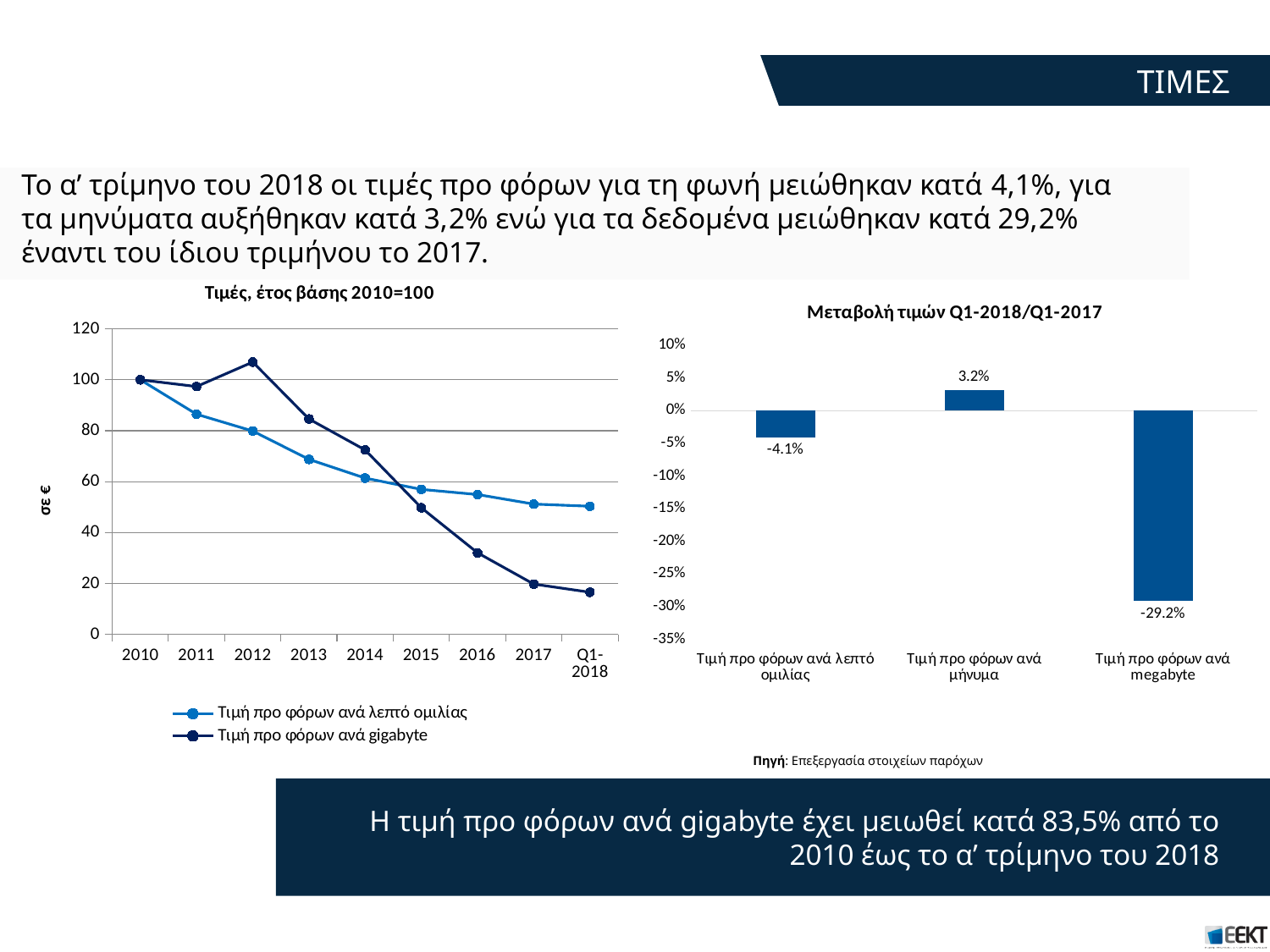
In the chart titled 'Μεταβολή τιμών Q1-2018/Q1-2017', which category has the lowest value? Τιμή προ φόρων ανά megabyte In the chart titled 'Μεταβολή τιμών Q1-2018/Q1-2017', what is the value for 'Τιμή προ φόρων ανά λεπτό ομιλίας'? -4.1% In the chart titled 'Τιμές, έτος βάσης 2010=100', what is the value of 'Τιμή προ φόρων ανά gigabyte' in 2010? 100 What kind of chart is the one titled 'Μεταβολή τιμών Q1-2018/Q1-2017'? Bar chart In the chart titled 'Μεταβολή τιμών Q1-2018/Q1-2017', what is the value for 'Τιμή προ φόρων ανά megabyte'? -29.2% In the chart titled 'Μεταβολή τιμών Q1-2018/Q1-2017', how many categories are shown? 3 What kind of chart is the one titled 'Τιμές, έτος βάσης 2010=100'? Line chart In the chart titled 'Τιμές, έτος βάσης 2010=100', does the 'Τιμή προ φόρων ανά gigabyte' series rise or fall from 2012 to Q1-2018? Fall In the chart titled 'Μεταβολή τιμών Q1-2018/Q1-2017', which category has the highest value? Τιμή προ φόρων ανά μήνυμα In the chart titled 'Τιμές, έτος βάσης 2010=100', how many series does the legend list? 2 In the chart titled 'Μεταβολή τιμών Q1-2018/Q1-2017', what is the value for 'Τιμή προ φόρων ανά μήνυμα'? 3.2% In the chart titled 'Τιμές, έτος βάσης 2010=100', is the value of 'Τιμή προ φόρων ανά gigabyte' in 2012 greater or less than 100? greater